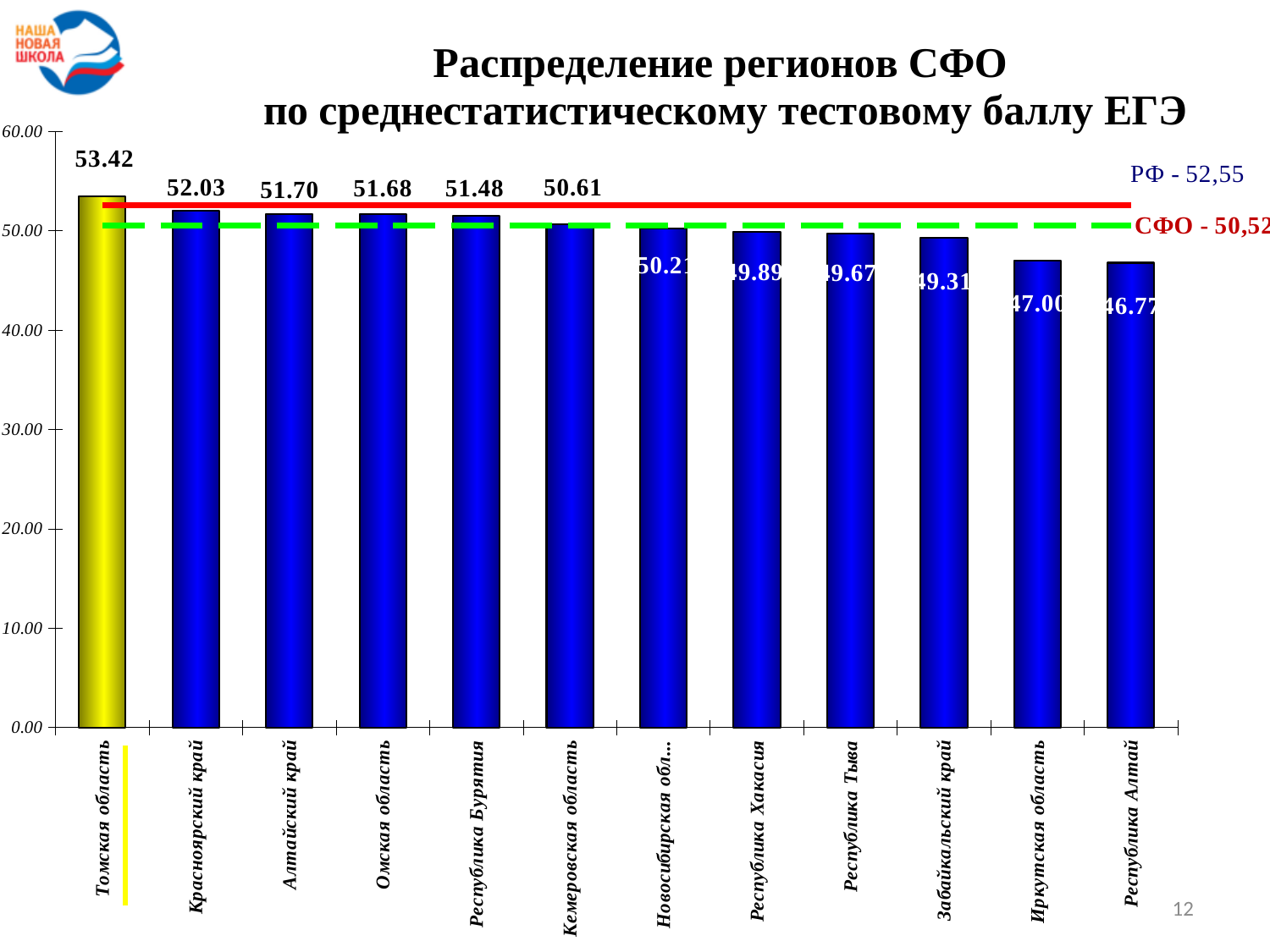
How many regions are shown on the chart? 12 What is the value for Иркутская область? 47.00 What kind of chart is shown on the slide? bar chart Is the value for Забайкальский край greater or less than 50.00? less Which region has the lowest value? Республика Алтай What is the difference between the values for Томская область and Красноярский край? 1.39 What is the value for Томская область? 53.42 Which region has the highest value? Томская область Which is larger, the value for Кемеровская область or the value for Республика Хакасия? Кемеровская область What is the value for Республика Алтай? 46.77 What is the value for Красноярский край? 52.03 What value does the red reference line labelled РФ represent? 52,55